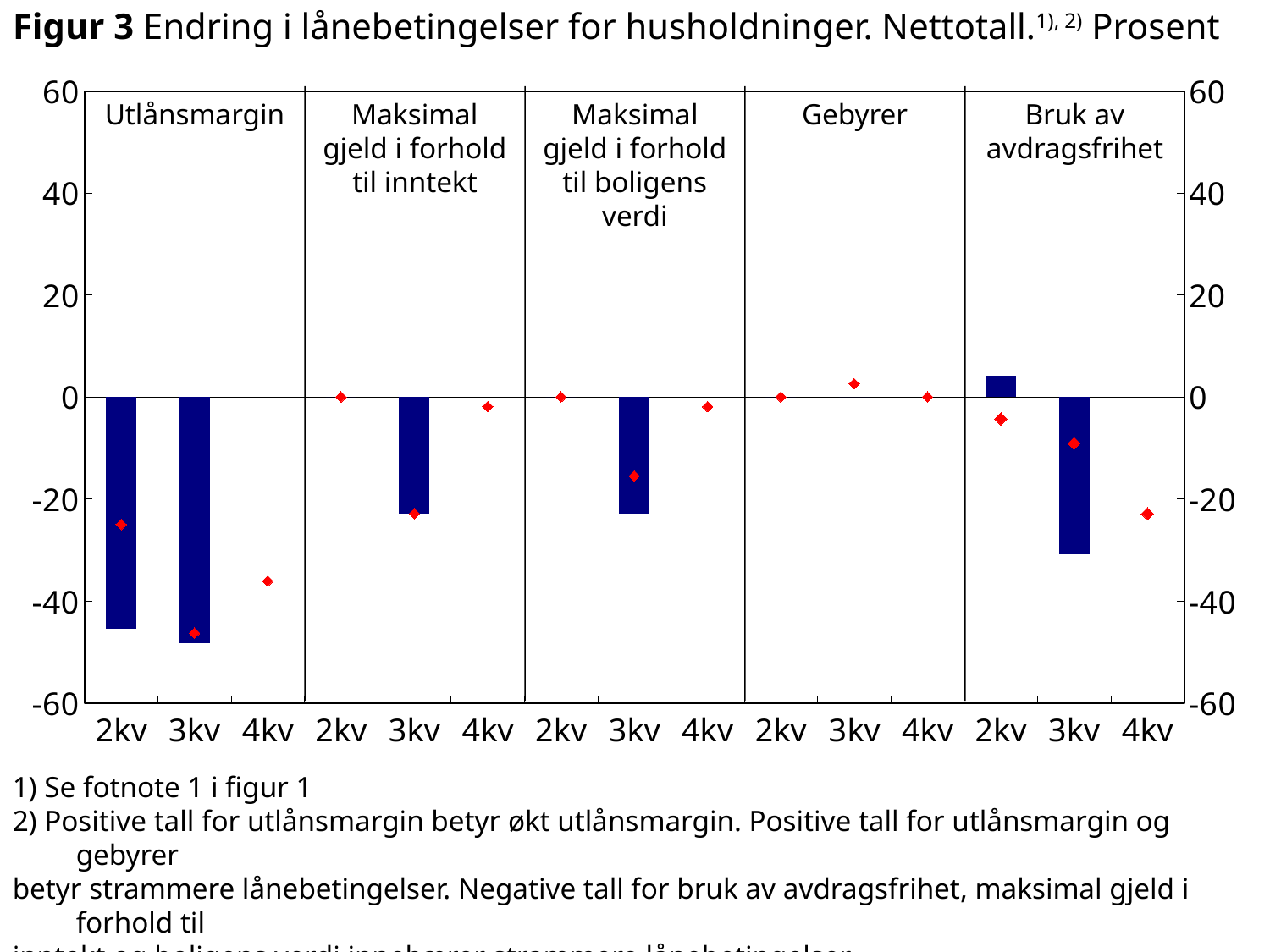
Which panel is the only one with a bar above zero? Bruk av avdragsfrihet What kind of chart is shown on the slide? bar chart How many quarters are shown on the x axis within each panel? 3 Which panel contains the lowest bar in the chart? Utlånsmargin Is the bar for Bruk av avdragsfrihet in 2kv greater or less than 0? greater What is the title of the chart? Figur 3 Endring i lånebetingelser for husholdninger. Nettotall. Prosent Is the red diamond marker for Utlånsmargin in 4kv greater or less than -20? less How many lending-condition panels (categories) does the chart show? 5 Is the bar for Maksimal gjeld i forhold til inntekt in 3kv greater or less than -20? less Which is lower, the 3kv bar for Utlånsmargin or the 3kv bar for Bruk av avdragsfrihet? Utlånsmargin